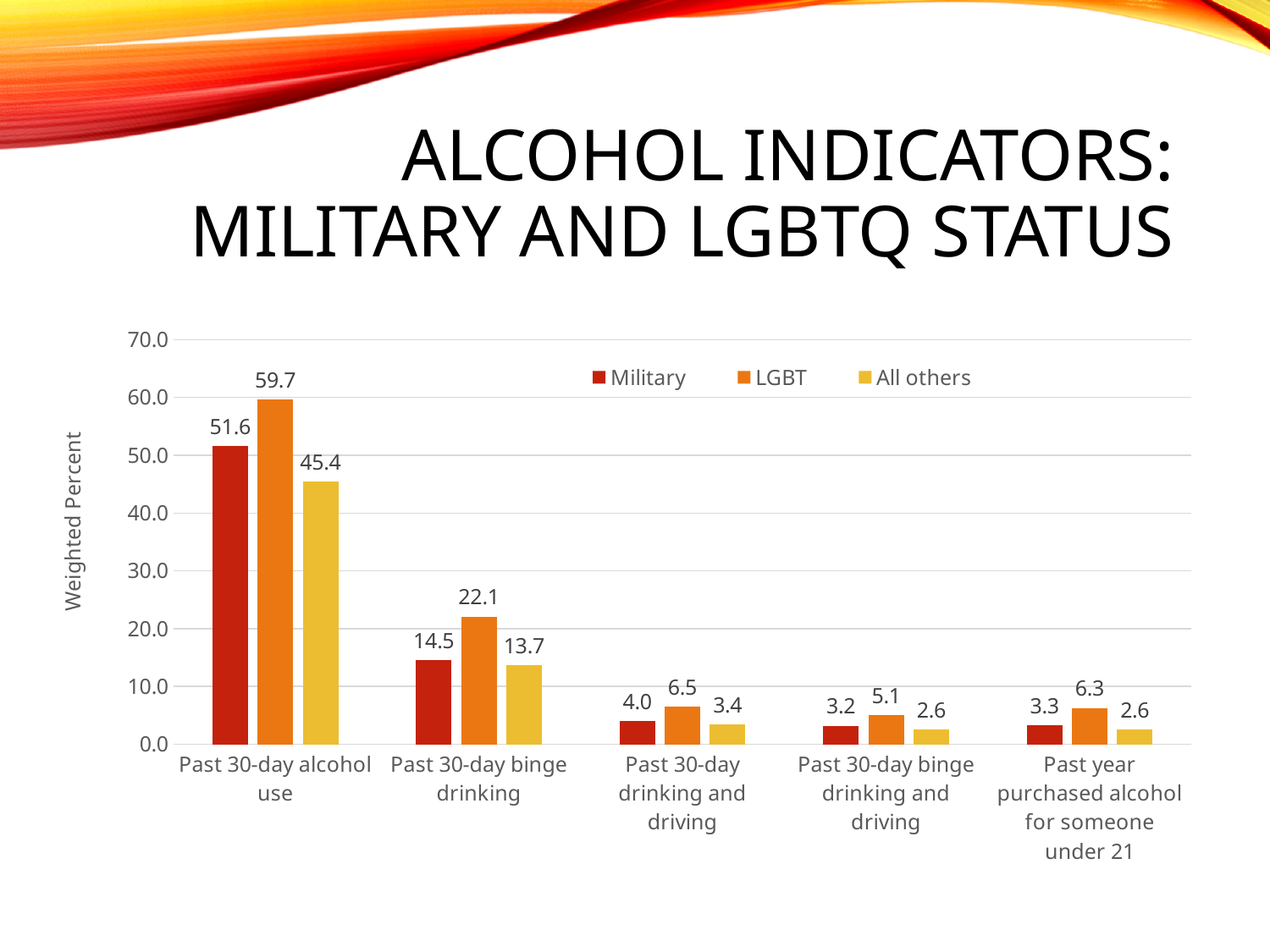
Which is larger for Past 30-day drinking and driving: the Military value or the All others value? Military How many series does the legend list? 3 How many categories are shown on the x axis? 5 What is the LGBT value for Past 30-day binge drinking? 22.1 What kind of chart is shown on the slide? Bar chart Which series has the lowest value for Past 30-day binge drinking and driving? All others What is the All others value for Past year purchased alcohol for someone under 21? 2.6 Is the All others value for Past 30-day alcohol use greater or less than 40.0? greater Which series has the highest value for Past 30-day alcohol use? LGBT What is the Military value for Past 30-day alcohol use? 51.6 What is the label on the vertical axis? Weighted Percent What is the difference between the LGBT and Military values for Past 30-day alcohol use? 8.1